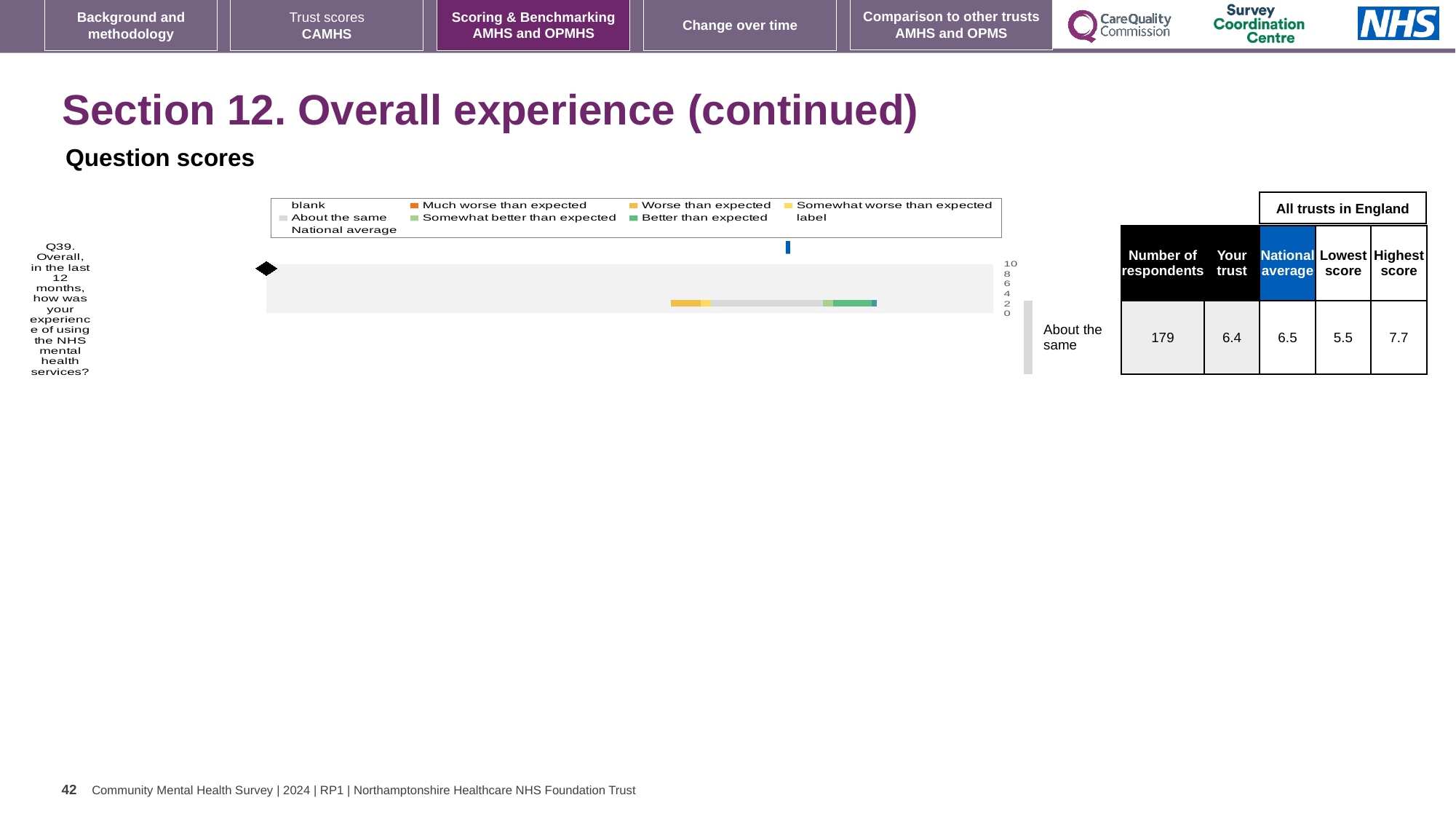
What is the difference between the highest score and the lowest score for Q39 in the table beside the chart? 2.2 In the table beside the chart, what is the 'Your trust' score for Q39? 6.4 How many questions are plotted in the question scores chart? 1 What kind of chart is used to show the Q39 question score? bar chart How many respondents answered Q39 according to the table beside the chart? 179 Which question is plotted in the question scores chart? Q39. Overall, in the last 12 months, how was your experience of using the NHS mental health services? In the table beside the chart, what is the lowest score among all trusts in England for Q39? 5.5 What benchmark category is shown to the right of the chart for Q39? About the same Which is larger for Q39, the 'Your trust' score or the national average? National average In the table beside the chart, what is the highest score among all trusts in England for Q39? 7.7 What is the maximum value shown on the chart's score axis? 10 In the table beside the chart, what is the national average score for Q39? 6.5